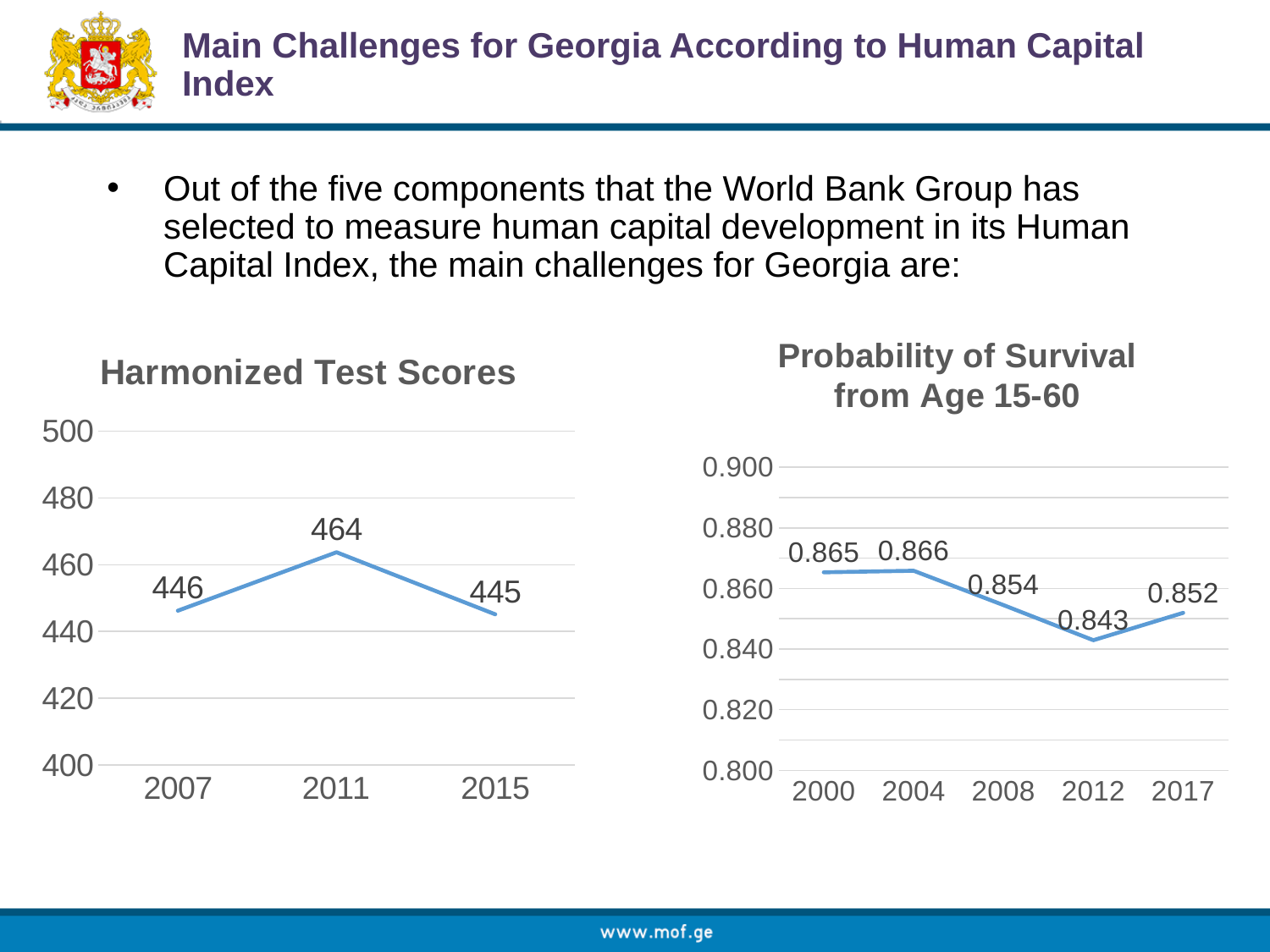
In the Harmonized Test Scores chart, what is the value for 2007? 446 In the Probability of Survival from Age 15-60 chart, what is the difference between the 2000 and 2012 values? 0.022 In the Harmonized Test Scores chart, which year has the lowest score? 2015 What kind of chart is the Harmonized Test Scores chart? line chart In the Harmonized Test Scores chart, what is the difference between the 2011 and 2015 values? 19 In the Probability of Survival from Age 15-60 chart, which is larger, the value for 2008 or the value for 2012? 2008 In the Probability of Survival from Age 15-60 chart, what is the value for 2012? 0.843 In the Probability of Survival from Age 15-60 chart, which year has the highest value? 2004 In the Harmonized Test Scores chart, how many years are plotted? 3 In the Harmonized Test Scores chart, what is the value for 2011? 464 In the Probability of Survival from Age 15-60 chart, what is the value for 2017? 0.852 In the Probability of Survival from Age 15-60 chart, how many years are plotted? 5